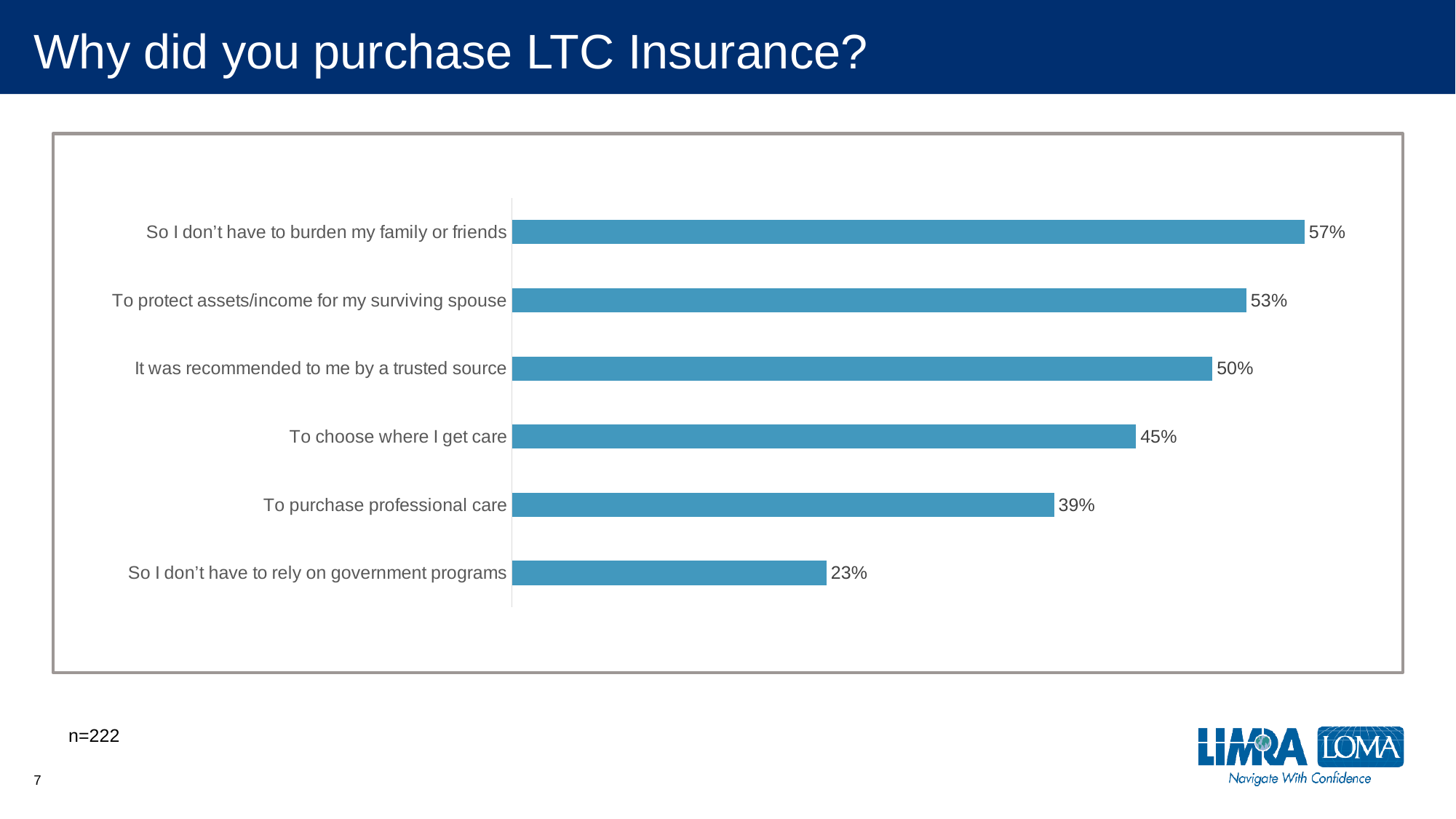
What percentage of respondents purchased LTC insurance so they don't have to burden their family or friends? 57% Which reason has the lowest percentage? So I don't have to rely on government programs What percentage cited "It was recommended to me by a trusted source"? 50% What is the title of the slide? Why did you purchase LTC Insurance? What is the value for "To protect assets/income for my surviving spouse"? 53% Which reason has the highest percentage? So I don't have to burden my family or friends What is the difference between "To choose where I get care" and "So I don't have to rely on government programs"? 22 percentage points What is the value for "To purchase professional care"? 39% Which is larger: "To protect assets/income for my surviving spouse" or "To purchase professional care"? To protect assets/income for my surviving spouse How many reasons are shown in the chart? 6 What type of chart is shown on the slide? Bar chart What is the sample size noted on the slide? n=222